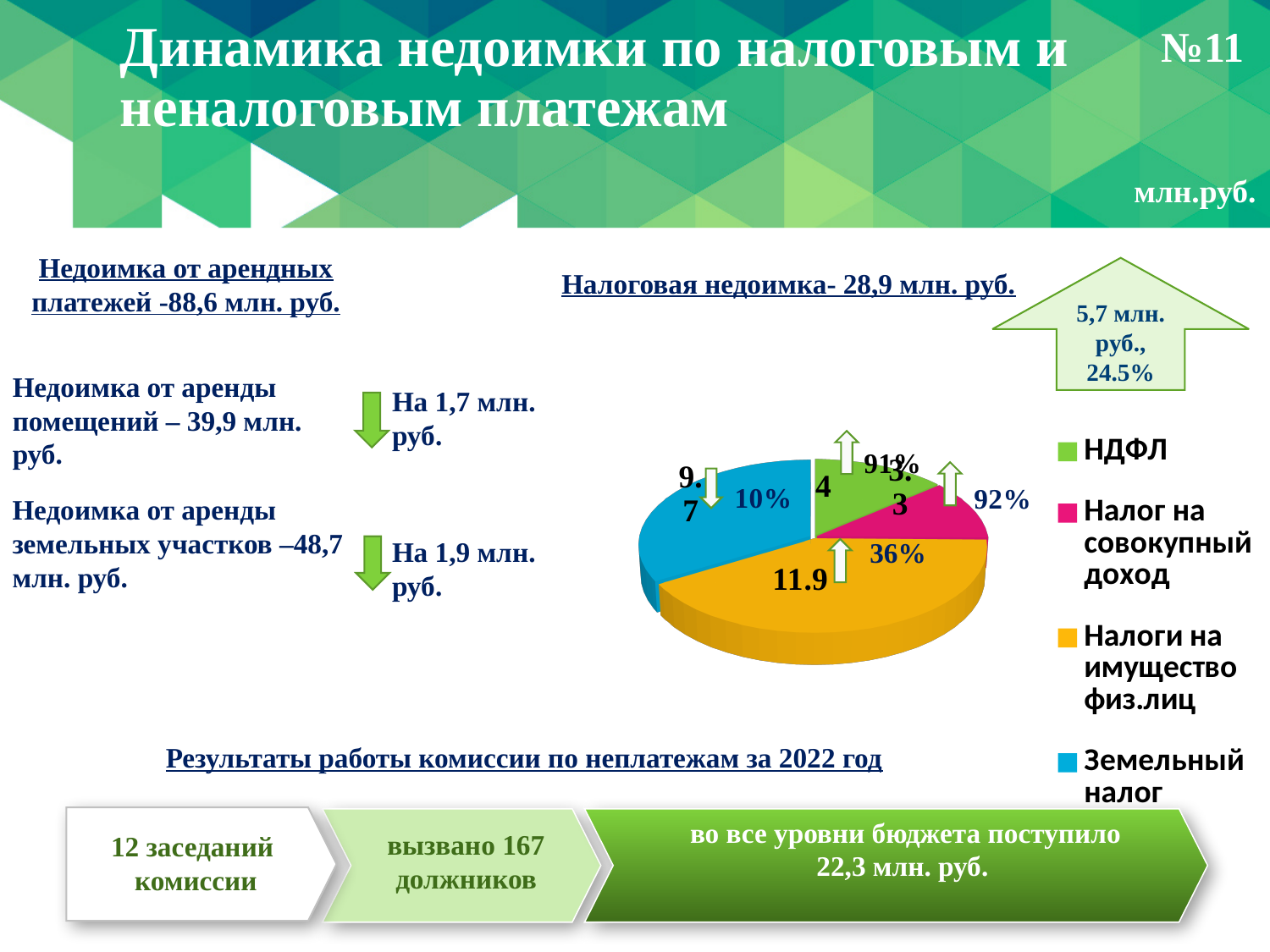
How many slices does the pie chart have? 4 What colour is the Земельный налог slice in the pie chart? blue What is the difference between the values for Налоги на имущество физ.лиц and Земельный налог in the pie chart? 2.2 What kind of chart is shown on the slide? pie chart Which is larger in the pie chart: НДФЛ or Земельный налог? Земельный налог What is the value for НДФЛ in the pie chart? 4 What is the value for Налоги на имущество физ.лиц in the pie chart? 11.9 How many entries does the legend of the pie chart list? 4 What is the value for Земельный налог in the pie chart? 9.7 What is the total of all slices in the pie chart? 28.9 Which category has the smallest slice in the pie chart? Налог на совокупный доход Which category has the largest slice in the pie chart? Налоги на имущество физ.лиц